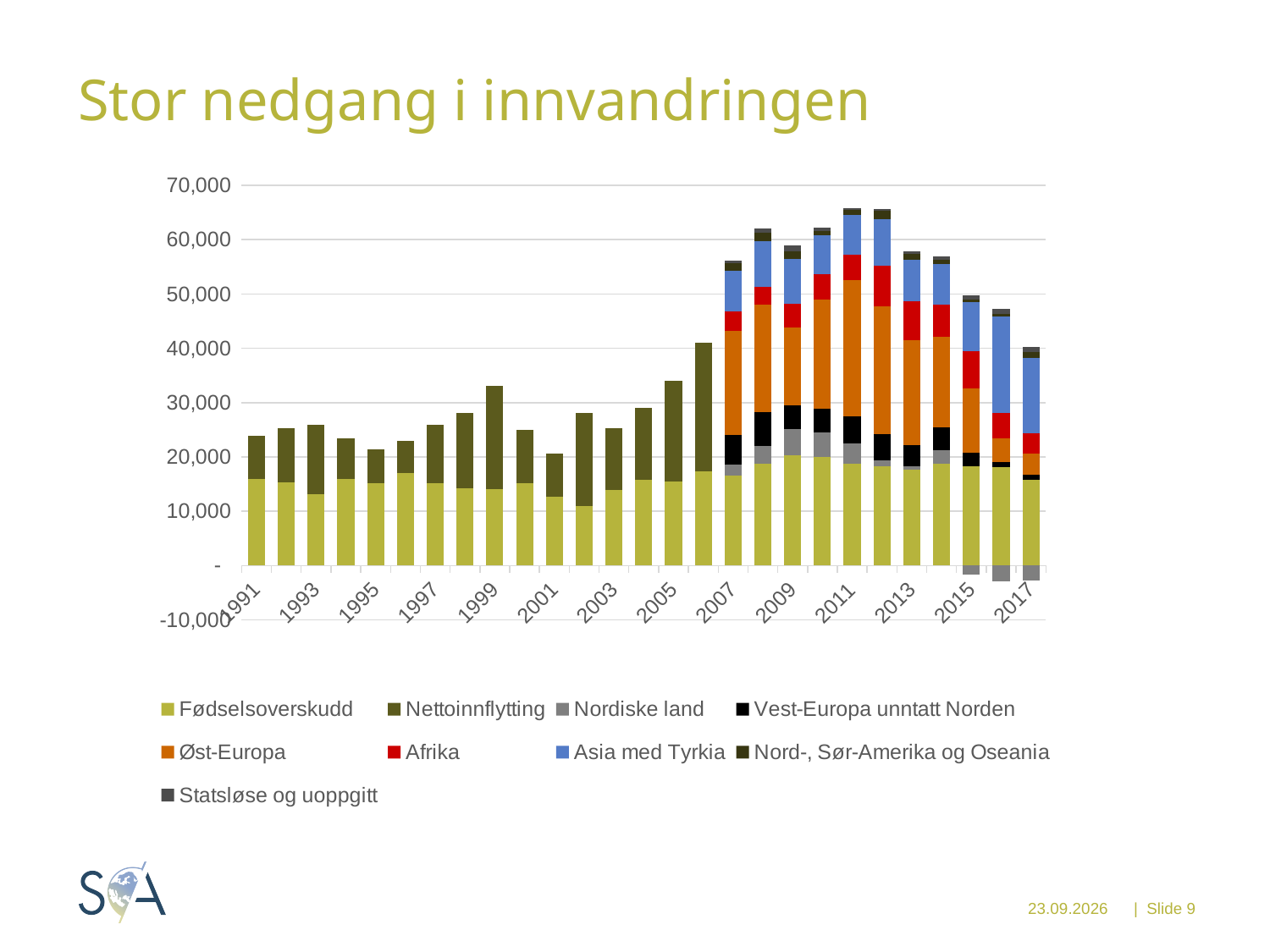
Do the total bar heights rise or fall from 2012 to 2017? fall What is the title of the slide containing the chart? Stor nedgang i innvandringen Is the total height of the stacked bar for 2011 greater or less than 60,000? greater Which year has the taller stacked bar, 2011 or 1991? 2011 What kind of chart is shown on the slide? stacked bar chart How many series does the legend list? 9 Is the total height of the stacked bar for 2016 greater or less than 50,000? less Which colour represents the series 'Asia med Tyrkia' in the legend? blue Is the total height of the stacked bar for 1991 greater or less than 20,000? greater How many years (bars) are plotted on the x axis, from 1991 to 2017? 27